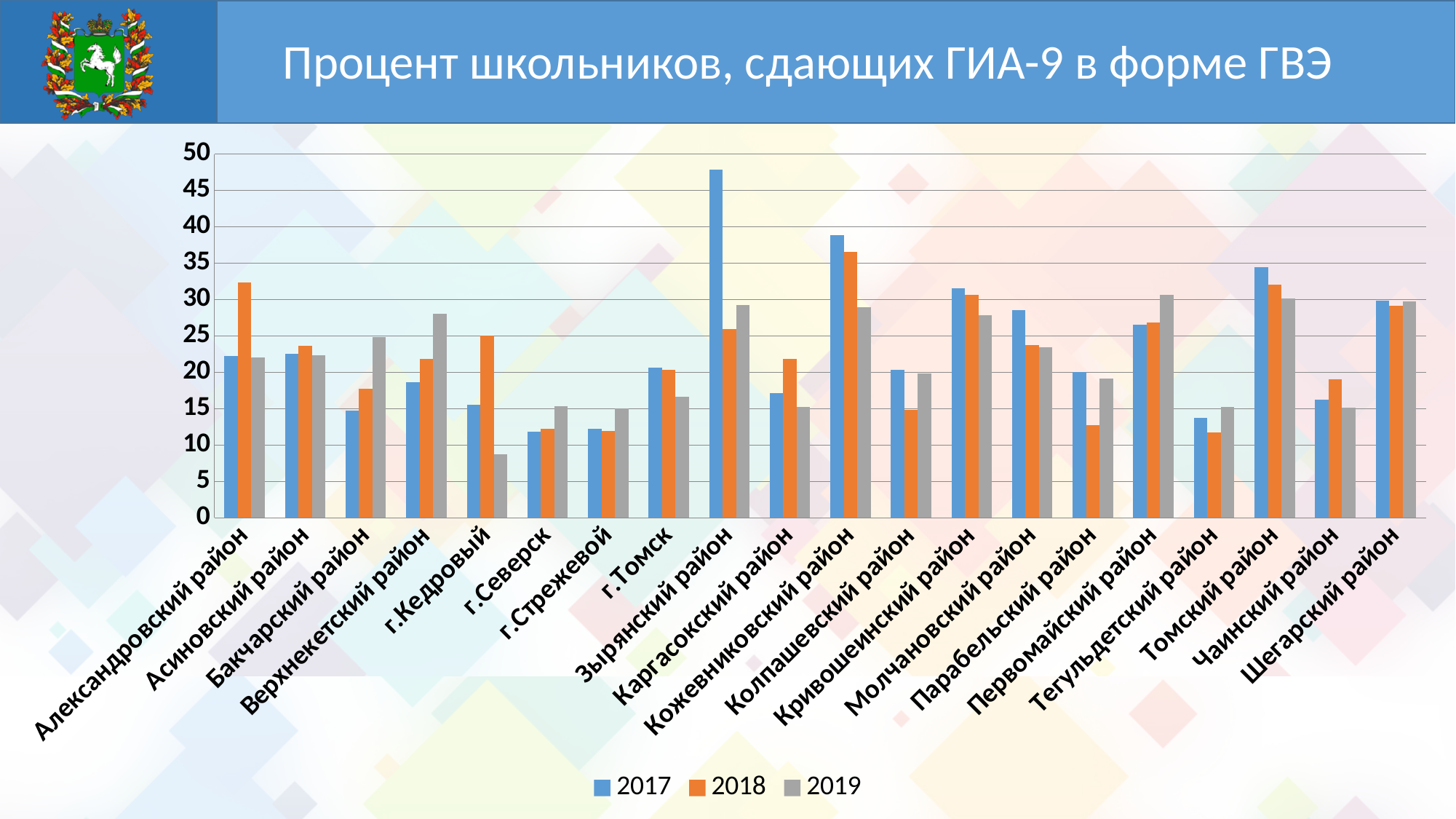
How many series does the legend list? 3 How many districts (categories) are shown on the x axis? 20 For Кожевниковский район, do the values rise or fall from 2017 to 2019? fall Which district has the highest value for 2017? Зырянский район Is the 2018 value for Александровский район greater or less than 30? greater Is the 2019 value for г.Кедровый greater or less than 10? less Which district has the highest value for 2018? Кожевниковский район Is the 2017 value for Зырянский район greater or less than 45? greater What is the title of the chart? Процент школьников, сдающих ГИА-9 в форме ГВЭ What kind of chart is shown on the slide? bar chart Which district has the lowest value for 2019? г.Кедровый For Александровский район, which is larger: the 2017 value or the 2018 value? 2018